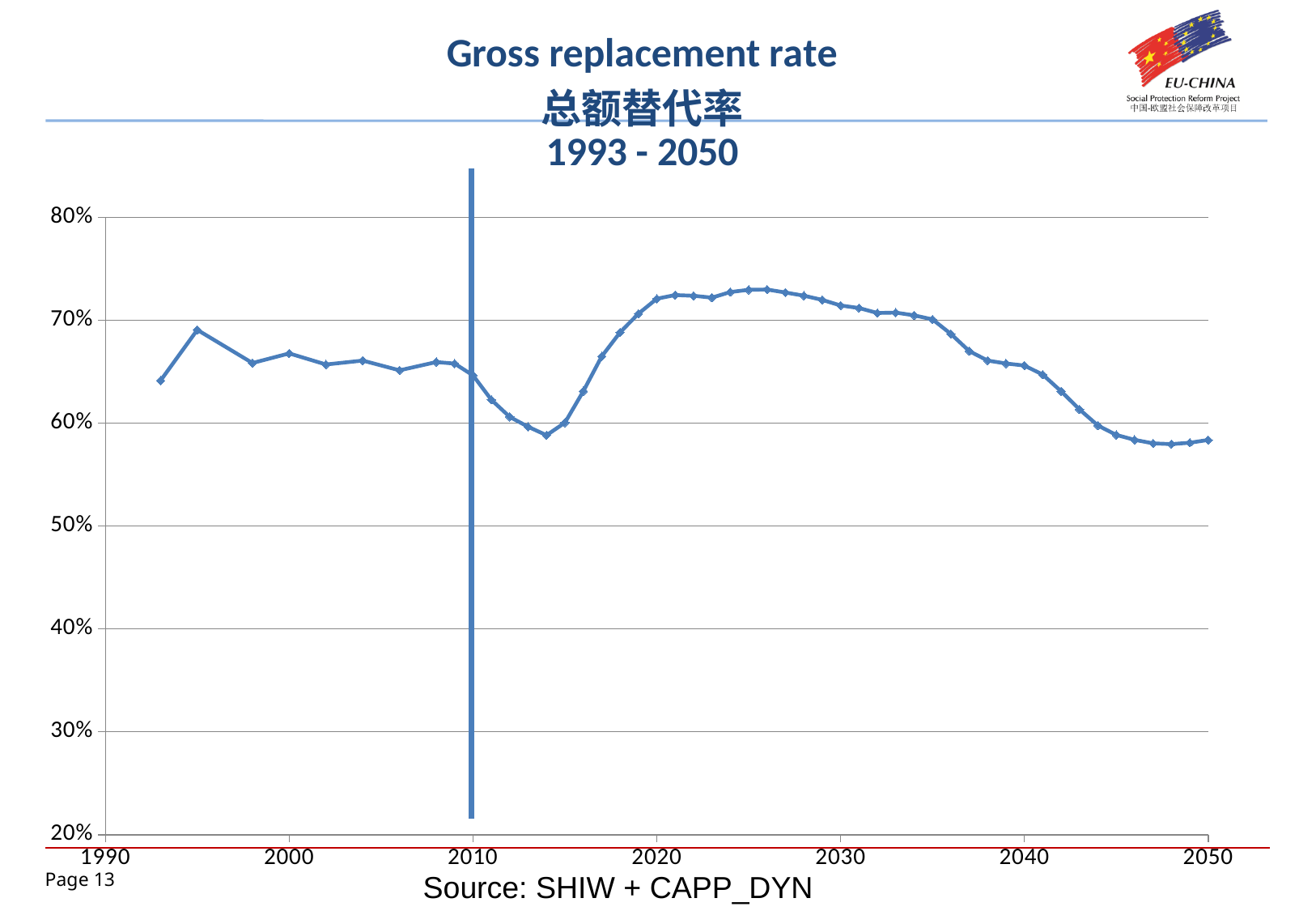
Between 2010 and 2014, does the gross replacement rate rise or fall? fall Is the gross replacement rate in 2014 greater or less than 60%? less Which is larger, the gross replacement rate in 1993 or in 2026? 2026 Is the gross replacement rate in 2050 greater or less than 60%? less Is the gross replacement rate in 2026 greater or less than 70%? greater Which is larger, the gross replacement rate in 2010 or in 2050? 2010 What kind of chart is shown on the slide? line chart Between 2014 and 2026, does the gross replacement rate rise or fall? rise What is the title of the chart? Gross replacement rate What source is cited below the chart? SHIW + CAPP_DYN